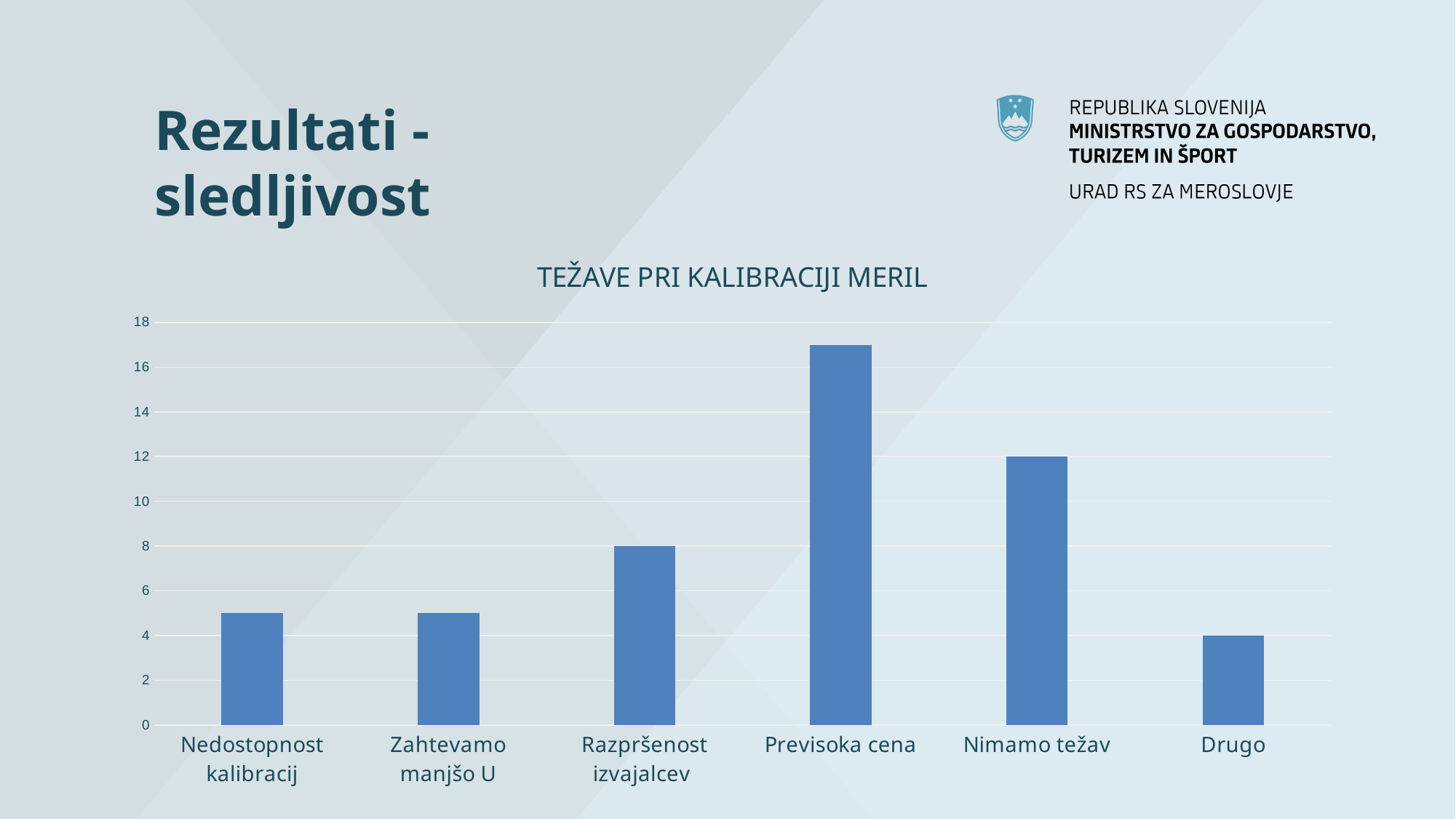
Is the value for Previsoka cena greater or less than 16? greater What kind of chart is shown on the slide? bar chart Which is larger, the value for Nimamo težav or the value for Razpršenost izvajalcev? Nimamo težav How many categories are shown on the x axis of the chart? 6 Is the value for Nedostopnost kalibracij greater or less than 6? less What is the difference between the values for Nimamo težav and Razpršenost izvajalcev? 4 What is the title of the chart? TEŽAVE PRI KALIBRACIJI MERIL What is the value for Nimamo težav? 12 Which category has the lowest value? Drugo Which category has the highest value? Previsoka cena What is the value for Razpršenost izvajalcev? 8 What is the value for Drugo? 4